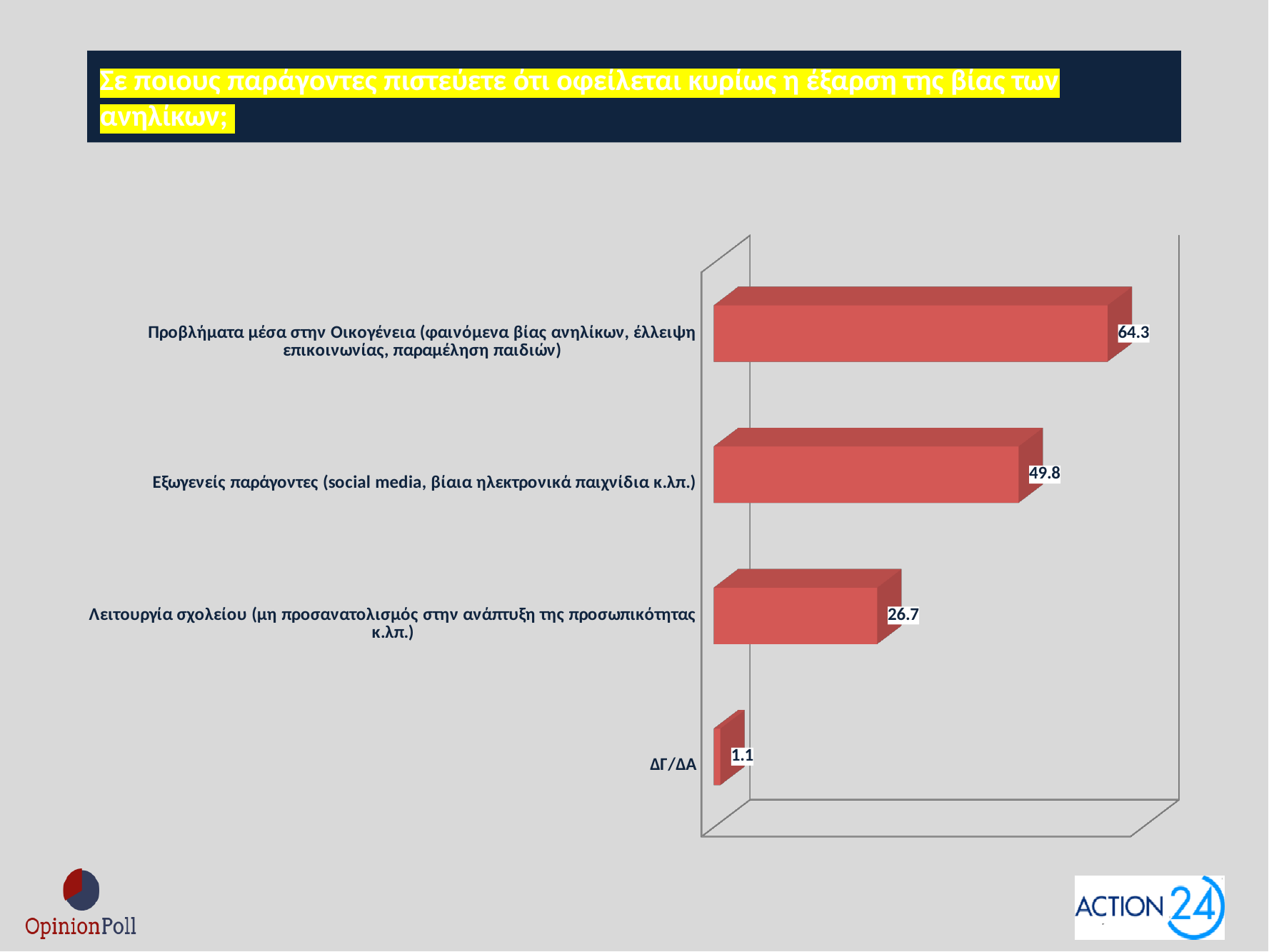
What is the value for 'Εξωγενείς παράγοντες (social media, βίαια ηλεκτρονικά παιχνίδια κ.λπ.)'? 49.8 What kind of chart is shown on the slide? Bar chart How many categories are shown in the chart? 4 Which category has the lowest value? ΔΓ/ΔΑ Which category has the highest value? Προβλήματα μέσα στην Οικογένεια (φαινόμενα βίας ανηλίκων, έλλειψη επικοινωνίας, παραμέληση παιδιών) What is the value for 'Προβλήματα μέσα στην Οικογένεια (φαινόμενα βίας ανηλίκων, έλλειψη επικοινωνίας, παραμέληση παιδιών)'? 64.3 What is the difference between the values for 'Εξωγενείς παράγοντες' and 'Λειτουργία σχολείου'? 23.1 What is the value for 'ΔΓ/ΔΑ'? 1.1 What is the difference between the values for 'Προβλήματα μέσα στην Οικογένεια' and 'Εξωγενείς παράγοντες'? 14.5 What is the title of the slide? Σε ποιους παράγοντες πιστεύετε ότι οφείλεται κυρίως η έξαρση της βίας των ανηλίκων; What is the value for 'Λειτουργία σχολείου (μη προσανατολισμός στην ανάπτυξη της προσωπικότητας κ.λπ.)'? 26.7 Which is larger: the value for 'Λειτουργία σχολείου' or the value for 'Εξωγενείς παράγοντες'? Εξωγενείς παράγοντες